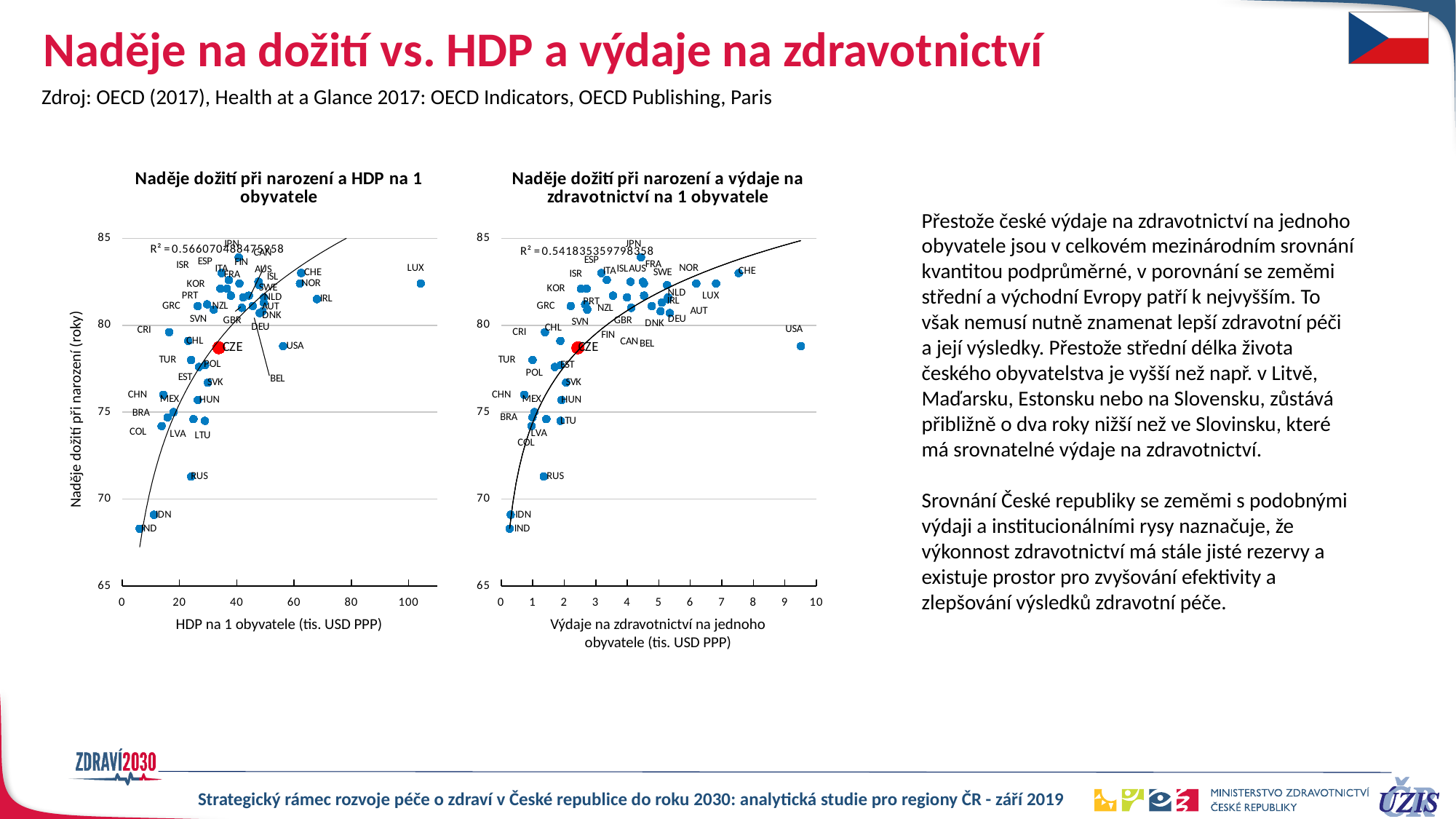
In the right chart (výdaje na zdravotnictví), what R² value is printed on the chart? R² = 0.541835359798358 In the left chart (HDP na 1 obyvatele), what R² value is printed on the chart? R² = 0.566070488475958 In the right chart (výdaje na zdravotnictví), is the life expectancy for RUS greater or less than 75? less In the right chart (výdaje na zdravotnictví), is the life expectancy for CZE greater or less than 75? greater In the right chart (výdaje na zdravotnictví), is the health expenditure per capita for USA greater or less than 9? greater What kind of chart is the left chart, 'Naděje dožití při narození a HDP na 1 obyvatele'? scatter chart In the left chart (HDP na 1 obyvatele), which country has the lowest life expectancy at birth? IND In the right chart (výdaje na zdravotnictví), does life expectancy generally rise or fall as health expenditure per capita increases along the x axis? rise In the right chart (výdaje na zdravotnictví), which has the higher health expenditure per capita, USA or CHE? USA In the left chart (HDP na 1 obyvatele), which country has the highest life expectancy at birth? JPN In the left chart (HDP na 1 obyvatele), which has the higher life expectancy, CZE or SVN? SVN